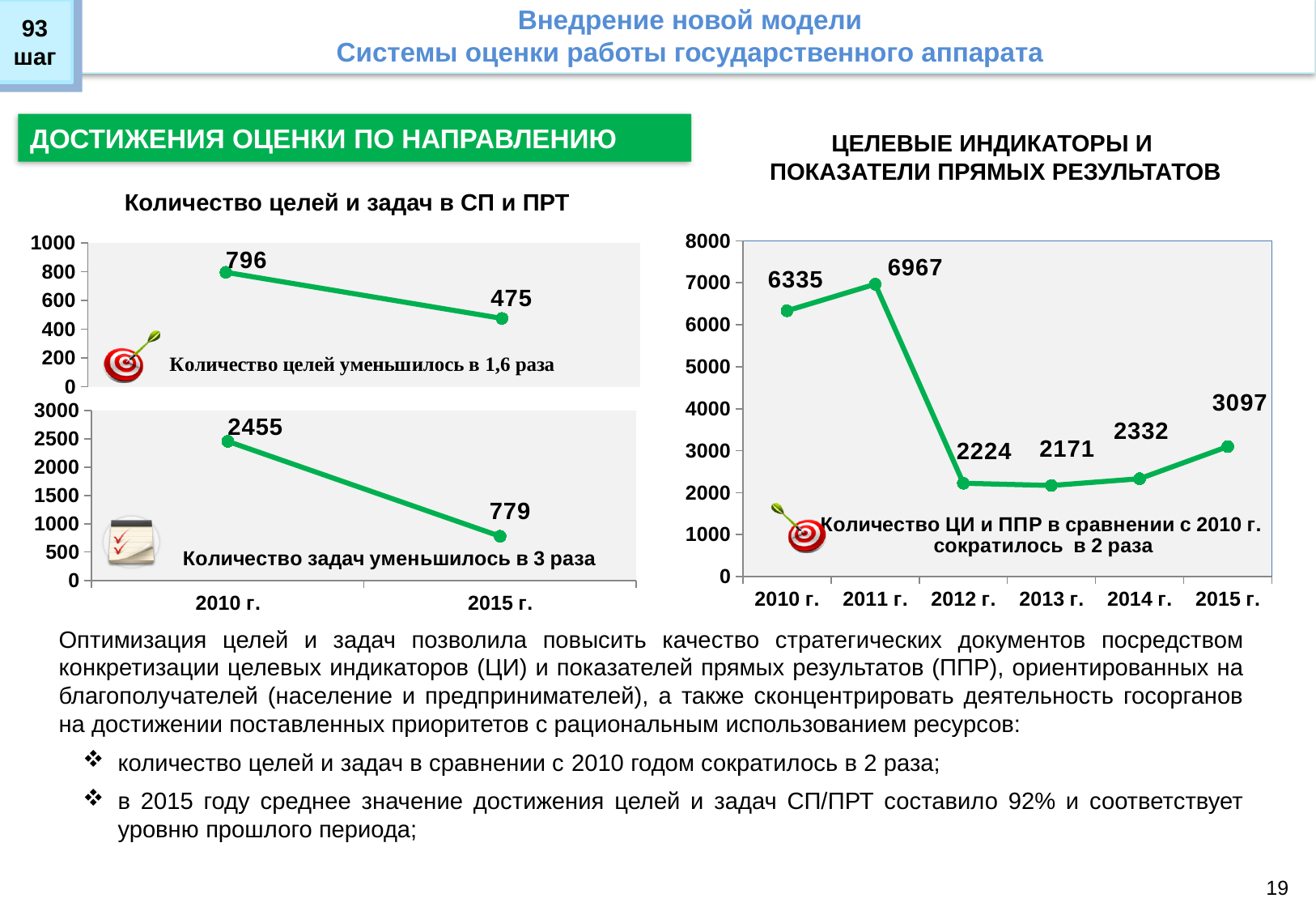
In the bottom-left chart (Количество задач), what is the value for 2015 г.? 779 In the right chart (Целевые индикаторы и показатели прямых результатов), which year has the highest value? 2011 г. In the right chart (Целевые индикаторы и показатели прямых результатов), how many years are plotted? 6 In the right chart (Целевые индикаторы и показатели прямых результатов), which year has the lowest value? 2013 г. In the top-left chart (Количество целей), what is the value for 2015 г.? 475 In the top-left chart (Количество целей), what is the difference between the 2010 г. and 2015 г. values? 321 In the bottom-left chart (Количество задач), do the values rise or fall from 2010 г. to 2015 г.? fall In the bottom-left chart (Количество задач), what is the value for 2010 г.? 2455 In the right chart (Целевые индикаторы и показатели прямых результатов), what is the difference between the 2010 г. and 2015 г. values? 3238 In the top-left chart (Количество целей), what is the value for 2010 г.? 796 In the right chart (Целевые индикаторы и показатели прямых результатов), what is the value for 2011 г.? 6967 What type of chart is the right chart (Целевые индикаторы и показатели прямых результатов)? line chart